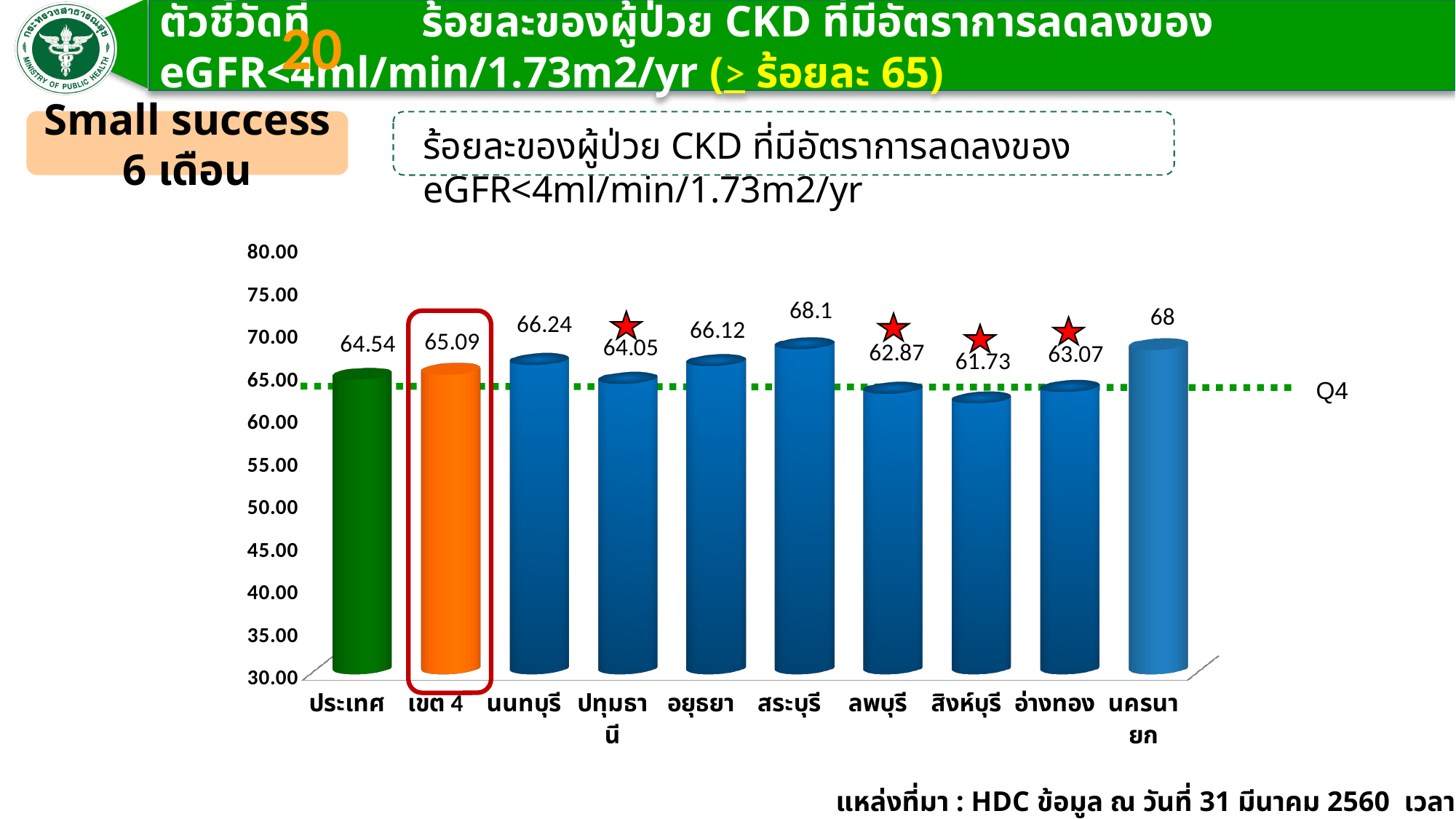
Is the value for ลพบุรี greater or less than 65.00? less What is the value for เขต 4? 65.09 How many categories are shown on the x axis? 10 What kind of chart is shown on the slide? bar chart What is the value for สระบุรี? 68.1 What is the value for สิงห์บุรี? 61.73 What is the value for ประเทศ? 64.54 Which is larger, the value for อยุธยา or the value for อ่างทอง? อยุธยา Which category has the lowest value? สิงห์บุรี What is the label of the dotted horizontal line on the chart? Q4 Which category has the highest value? สระบุรี What is the difference between the values for นนทบุรี and ปทุมธานี? 2.19